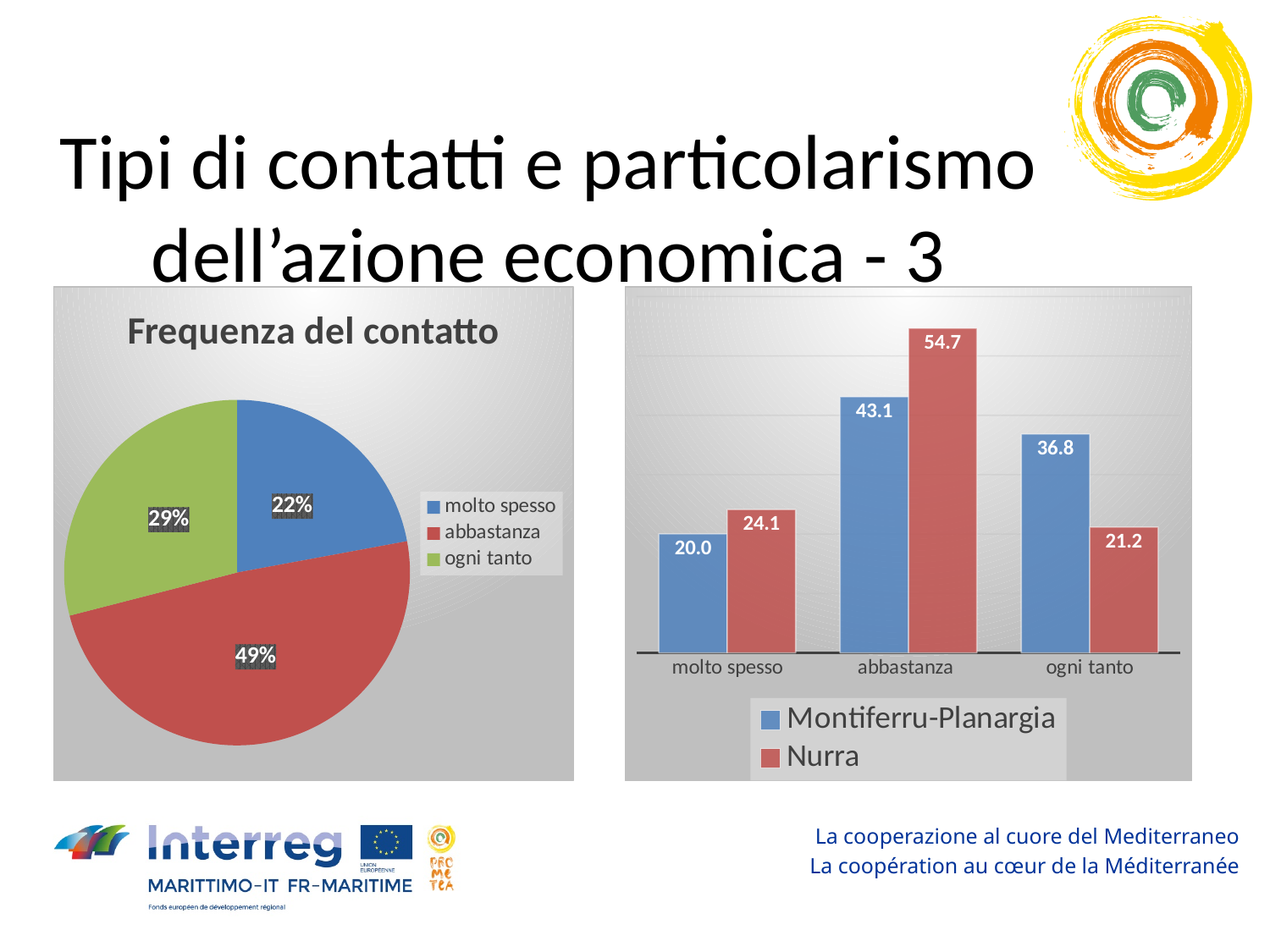
In the pie chart titled "Frequenza del contatto", how many categories are shown? 3 In the pie chart titled "Frequenza del contatto", what share does "abbastanza" have? 49% In the bar chart on the right, what is the difference between Nurra and Montiferru-Planargia in the "abbastanza" category? 11.6 In the pie chart titled "Frequenza del contatto", what share does "molto spesso" have? 22% In the bar chart on the right, how many series does the legend list? 2 In the bar chart on the right, what is the value for Montiferru-Planargia in the "ogni tanto" category? 36.8 In the pie chart titled "Frequenza del contatto", which category has the largest slice? abbastanza What type of chart is the chart on the right of the slide? bar chart In the bar chart on the right, what is the value for Nurra in the "abbastanza" category? 54.7 In the bar chart on the right, which category has the highest value for Montiferru-Planargia? abbastanza In the bar chart on the right, which series has the higher value in the "ogni tanto" category? Montiferru-Planargia In the pie chart titled "Frequenza del contatto", which category has the smallest slice? molto spesso